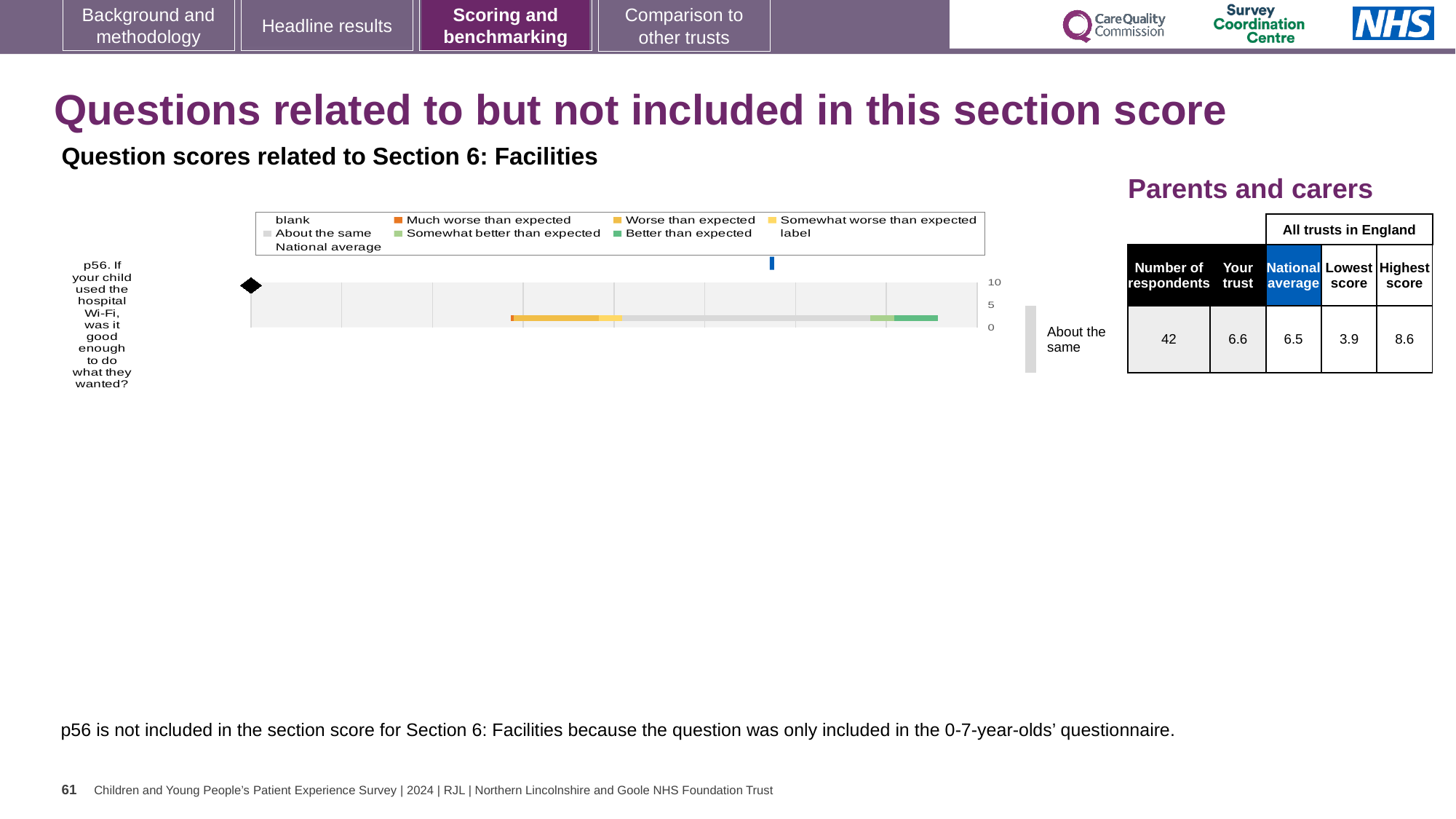
Which question number is plotted in the chart? p56 What is the difference between the Highest score and the Lowest score for p56 in the table? 4.7 In the table next to the chart, how many respondents answered p56? 42 In the table next to the chart, what is the Highest score among all trusts in England for p56? 8.6 In the table next to the chart, what is the 'Your trust' score for p56? 6.6 What kind of chart is shown on the slide? bar chart In the table next to the chart, what is the National average score for p56? 6.5 Which is larger for p56, the 'Your trust' score or the National average? Your trust What benchmark category is the trust's score for p56 labelled as? About the same What is the highest value shown on the chart's axis? 10 How many questions (categories) are plotted in the chart? 1 In the table next to the chart, what is the Lowest score among all trusts in England for p56? 3.9